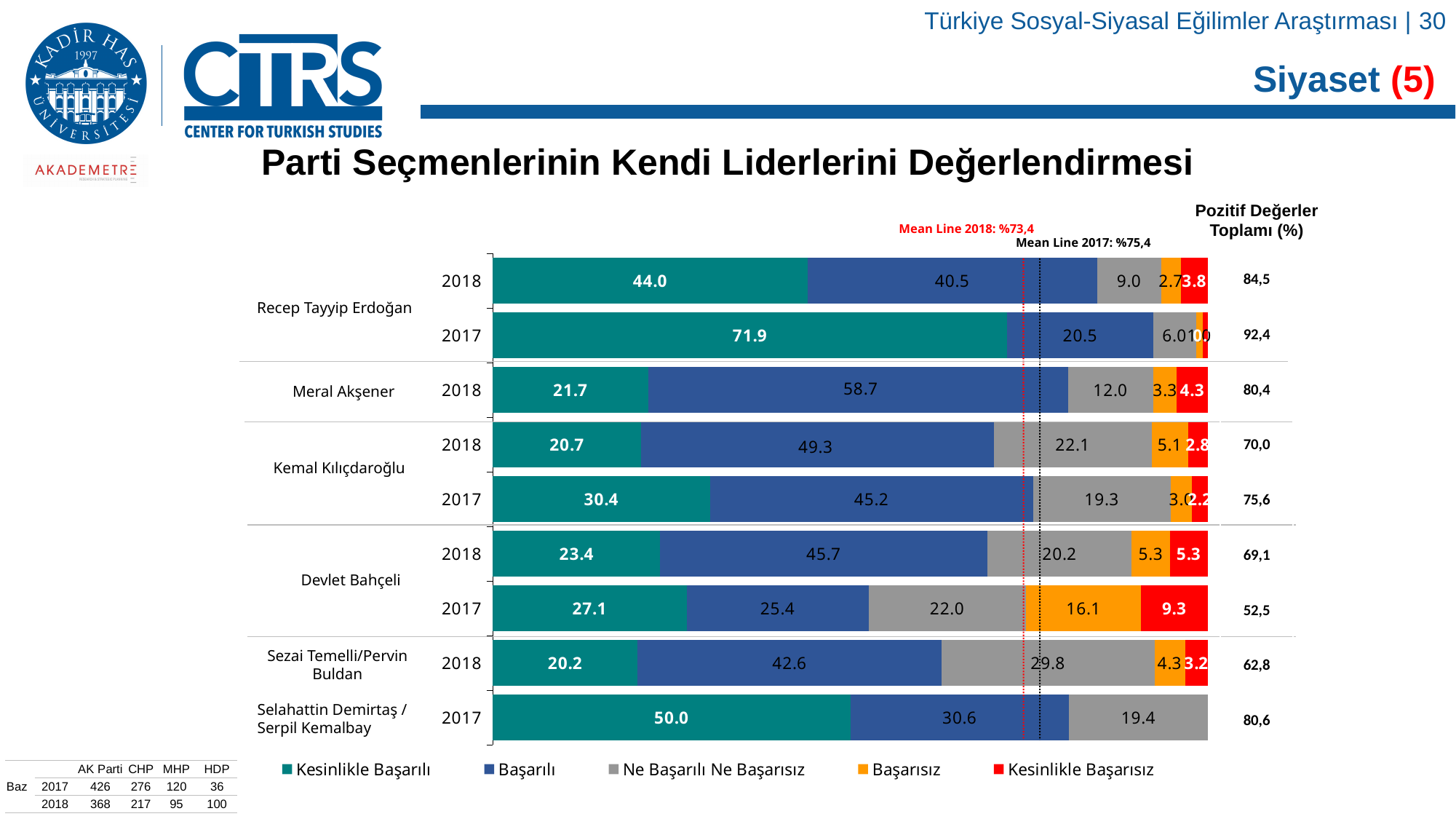
What is the 'Pozitif Değerler Toplamı (%)' for Kemal Kılıçdaroğlu in 2018? 70,0 How many bars are shown in the chart? 9 What is the 'Kesinlikle Başarılı' value for Recep Tayyip Erdoğan in 2018? 44.0 What is the 'Başarılı' value for Meral Akşener in 2018? 58.7 Which bar has the highest 'Kesinlikle Başarılı' value? Recep Tayyip Erdoğan 2017 What is the 'Başarısız' value for Devlet Bahçeli in 2017? 16.1 Which bar has the lowest 'Pozitif Değerler Toplamı (%)'? Devlet Bahçeli 2017 What kind of chart is shown on the slide? Stacked bar chart Which is larger: the 'Ne Başarılı Ne Başarısız' value for Sezai Temelli/Pervin Buldan in 2018 or for Kemal Kılıçdaroğlu in 2018? Sezai Temelli/Pervin Buldan 2018 What is the difference between Recep Tayyip Erdoğan's 'Kesinlikle Başarılı' value in 2017 and in 2018? 27.9 What is the value of the 2018 mean line shown on the chart? %73,4 How many series does the legend list? 5